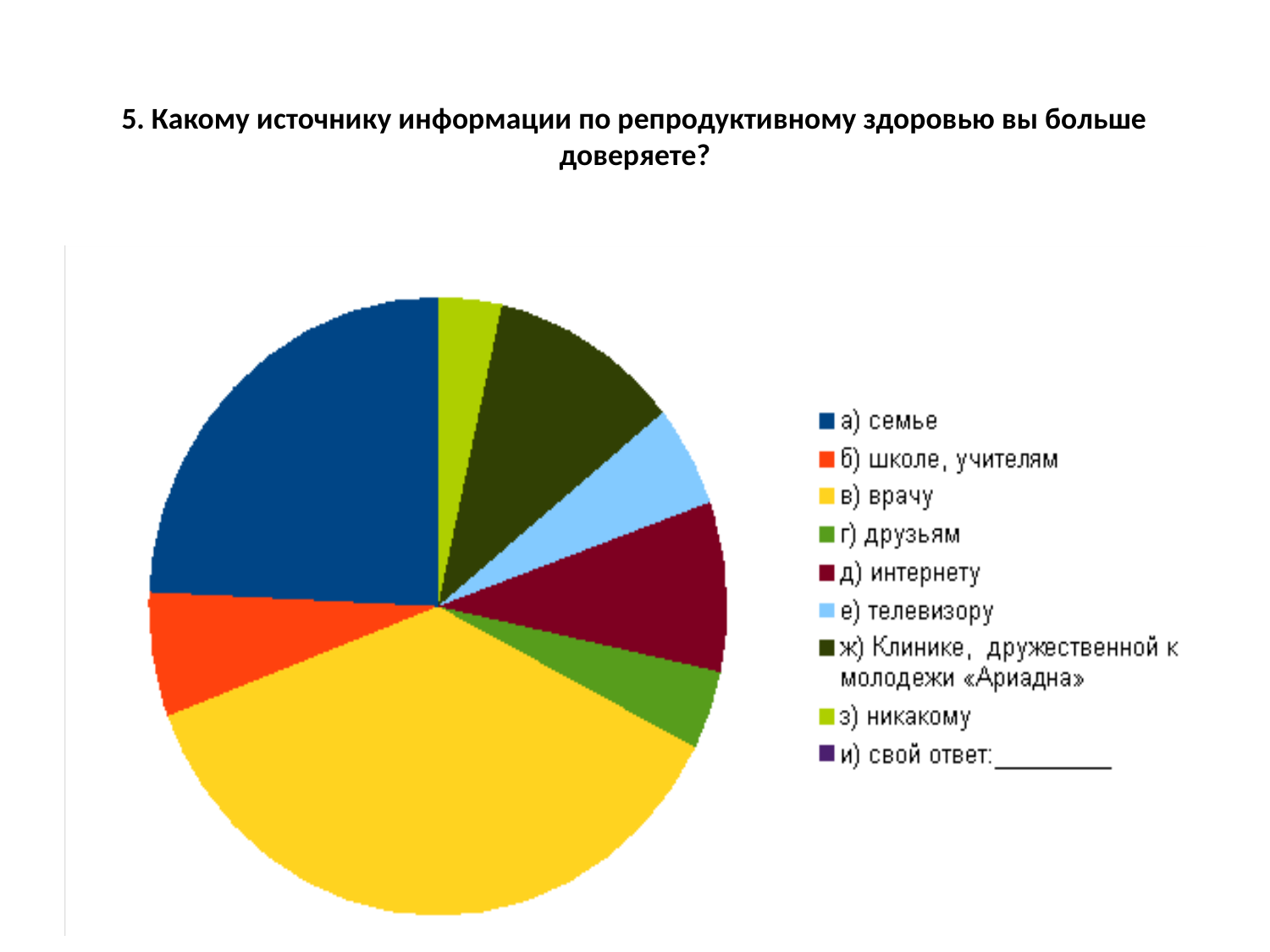
What kind of chart is shown on the slide? pie chart What is the title of the chart on the slide? 5. Какому источнику информации по репродуктивному здоровью вы больше доверяете? Which slice is larger: ж) Клинике, дружественной к молодежи «Ариадна» or е) телевизору? ж) Клинике, дружественной к молодежи «Ариадна» Which slice is larger: в) врачу or а) семье? в) врачу What colour is the slice for в) врачу in the pie chart? yellow How many entries does the legend of the pie chart list? 9 Which slice is larger: д) интернету or г) друзьям? д) интернету Which source of information has the largest slice of the pie chart? в) врачу